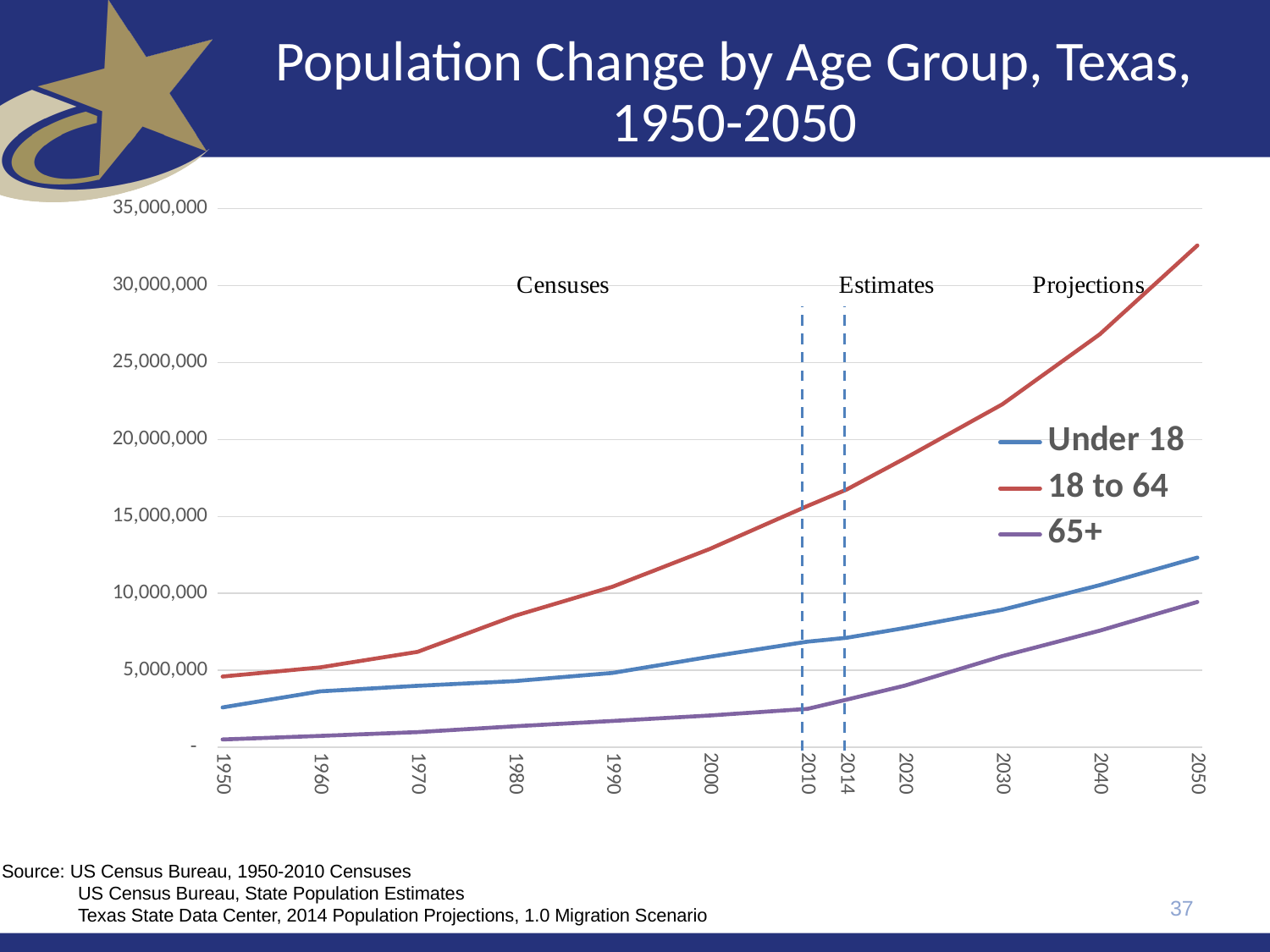
What kind of chart is shown on the slide? Line chart Is the value for 18 to 64 in 2050 greater or less than 30,000,000? greater In 2030, which is larger: the Under 18 population or the 65+ population? Under 18 Which age group has the highest population in 2050? 18 to 64 Is the value for 18 to 64 in 1950 greater or less than 5,000,000? less How many years are labelled on the x axis? 12 Is the value for Under 18 in 2050 greater or less than 10,000,000? greater What colour is the line for the 65+ age group? Purple How many series does the legend list? 3 Which age group has the lowest population in 1950? 65+ Does the 18 to 64 population rise or fall from 1950 to 2050? Rise